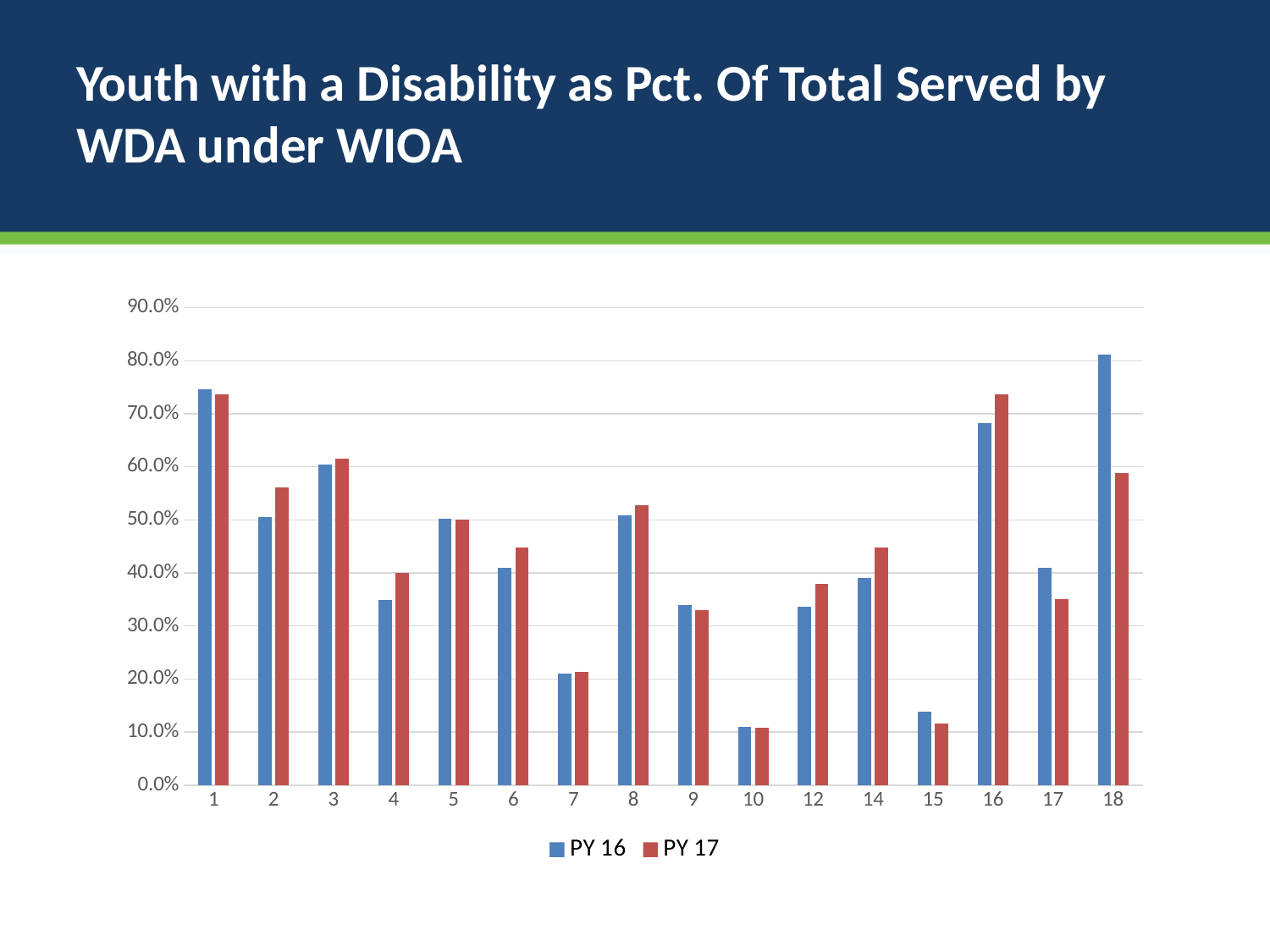
What kind of chart is shown on the slide? Bar chart Is the PY 17 value for WDA 7 greater or less than 30.0%? less Which WDA has the lowest PY 16 value? 10 What colour are the PY 17 bars? Red For WDA 17, which is larger, the PY 16 value or the PY 17 value? PY 16 Is the PY 16 value for WDA 4 greater or less than 40.0%? less Is the PY 16 value for WDA 18 greater or less than 70.0%? greater How many series does the legend list? 2 How many WDA categories are shown on the x axis? 16 Which WDA has the highest PY 16 value? 18 For WDA 14, which is larger, the PY 16 value or the PY 17 value? PY 17